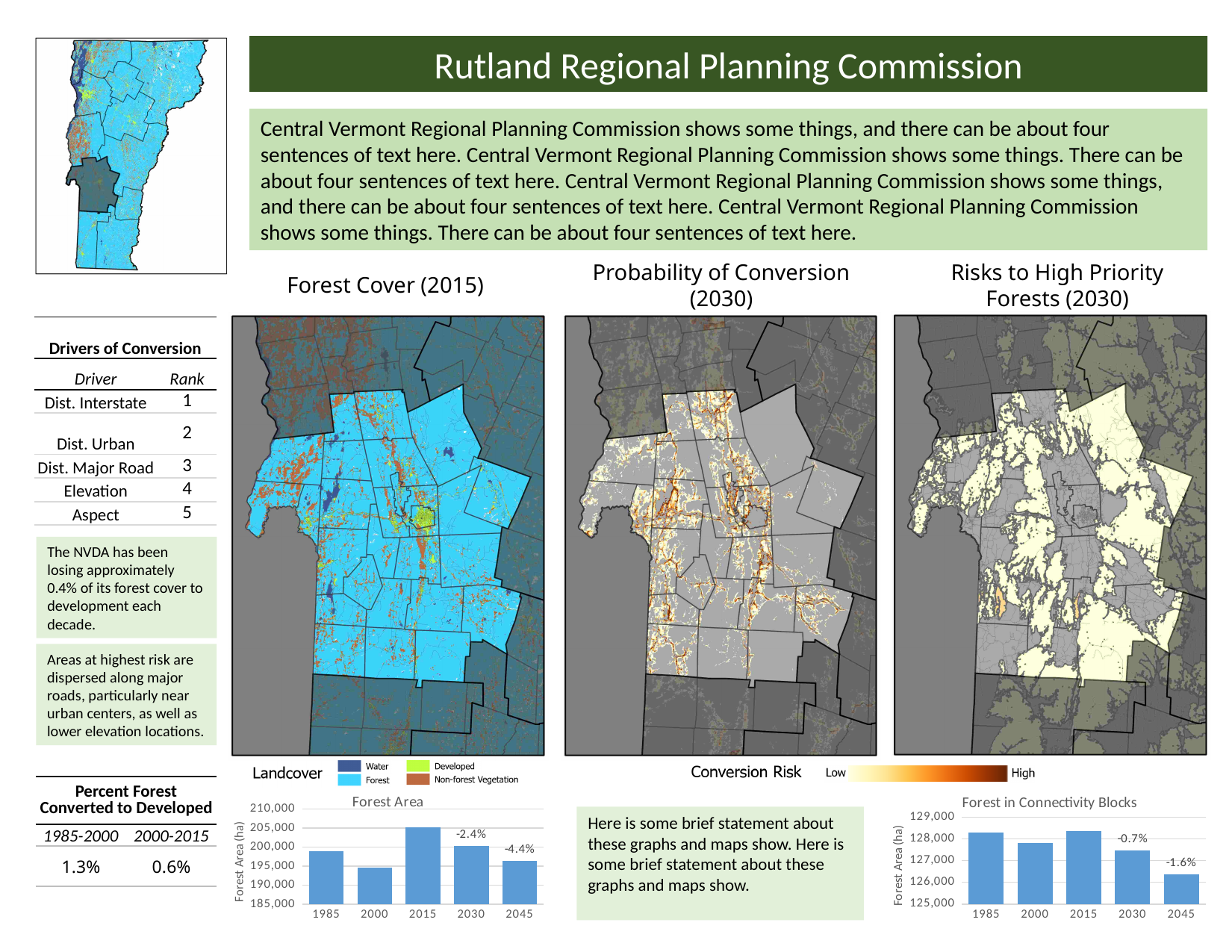
What kind of chart is the Forest in Connectivity Blocks chart? Bar chart In the Forest Area chart, which year has the highest forest area? 2015 In the Forest Area chart, which year has the lowest forest area? 2000 In the Forest in Connectivity Blocks chart, what percentage change label is shown on the 2030 bar? -0.7% In the Forest in Connectivity Blocks chart, which year has the lowest value? 2045 In the Forest Area chart, what percentage change label is shown on the 2045 bar? -4.4% In the Forest Area chart, what percentage change label is shown on the 2030 bar? -2.4% In the Forest in Connectivity Blocks chart, is the value for 2045 greater or less than 127,000? less In the Forest in Connectivity Blocks chart, what percentage change label is shown on the 2045 bar? -1.6% In the Forest Area chart, is the value for 2015 greater or less than 200,000? greater How many years are plotted in the Forest Area chart? 5 In the Forest in Connectivity Blocks chart, which is larger, the value for 2030 or the value for 2045? 2030